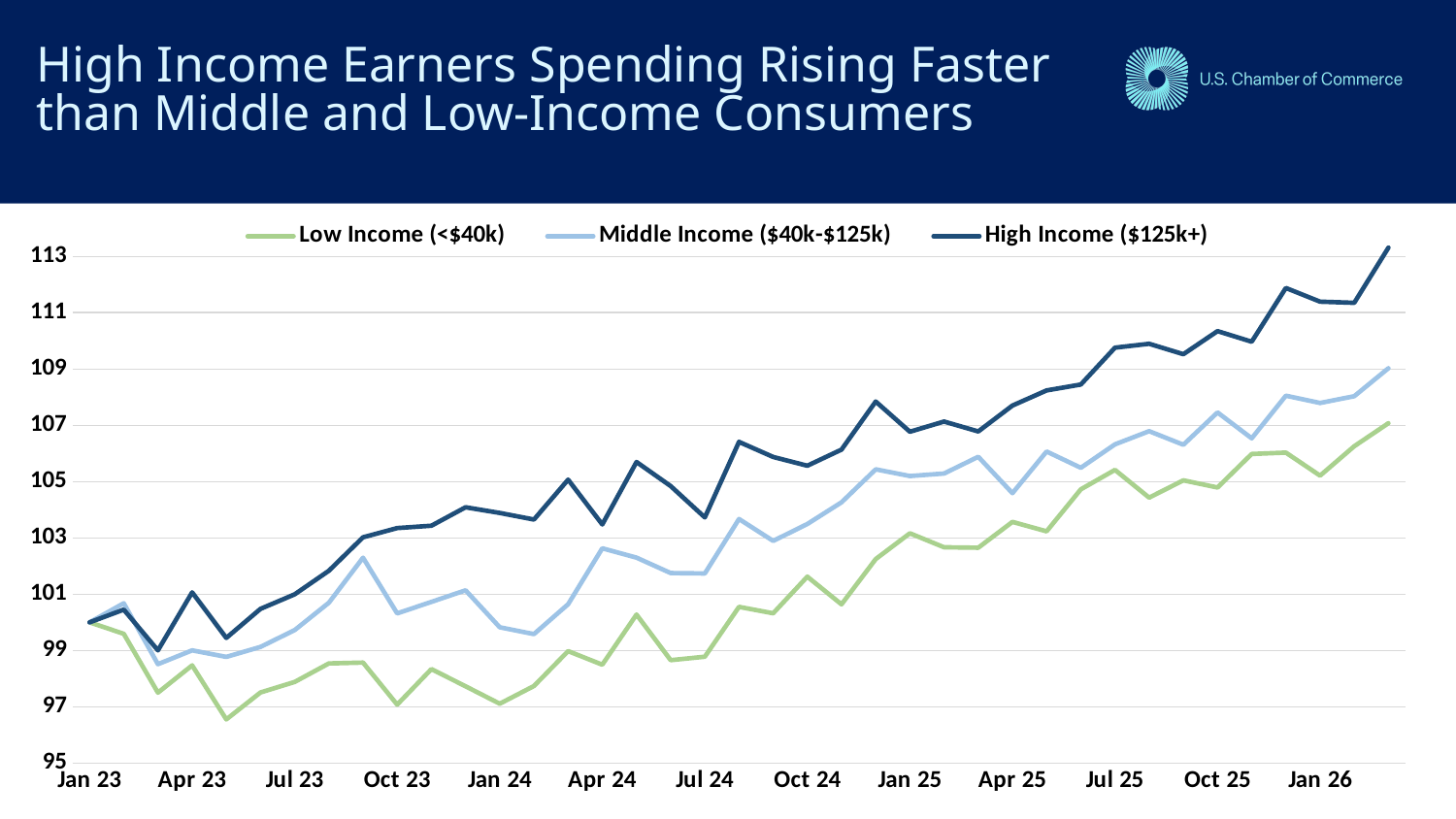
Does the High Income ($125k+) line generally rise or fall from Jan 23 to Jan 26? Rise Which series has the lowest value at Jan 24? Low Income (<$40k) Is the value for Low Income (<$40k) at Jan 24 greater or less than 99? less What kind of chart is shown on the slide? Line chart Is the value for Middle Income ($40k-$125k) at Jan 25 greater or less than 103? greater Which series has the highest value at the final point of the chart? High Income ($125k+) How many date labels are shown on the x axis? 13 At Jan 26, which is larger: the High Income ($125k+) value or the Low Income (<$40k) value? High Income ($125k+) How many series does the legend list? 3 What are the three series named in the legend? Low Income (<$40k), Middle Income ($40k-$125k), High Income ($125k+) What is the title of the slide? High Income Earners Spending Rising Faster than Middle and Low-Income Consumers Is the value for High Income ($125k+) at Oct 25 greater or less than 109? greater